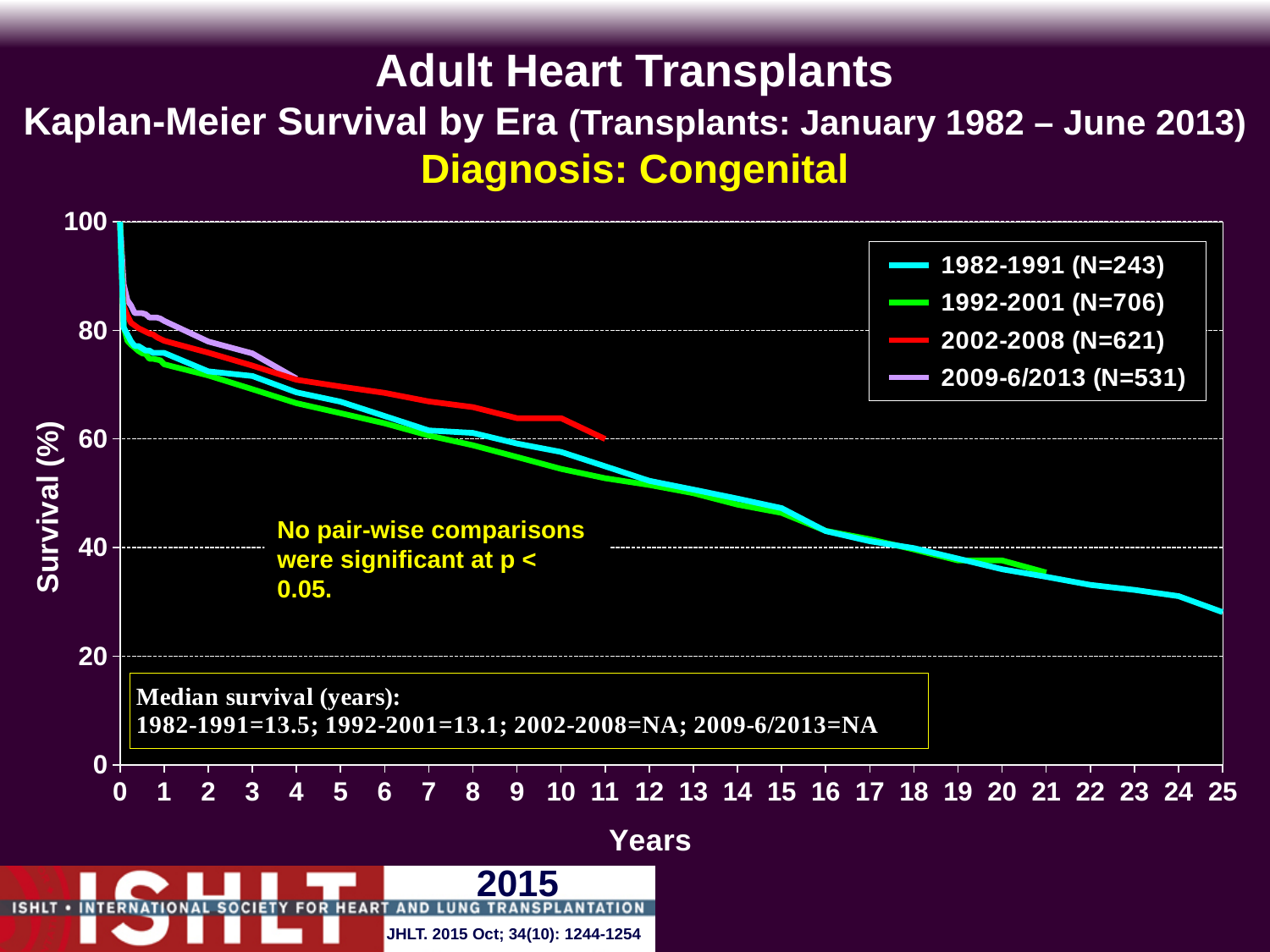
Which era has the largest N in the legend? 1992-2001 Is the survival for the 2002-2008 era at 5 years greater or less than 60? greater What is the median survival for the 2002-2008 era? NA How many series does the legend list? 4 Which era has the smallest N in the legend? 1982-1991 What is the difference in N between the 1992-2001 era and the 2002-2008 era? 85 Do the survival curves rise or fall as years increase? fall What is the N for the 1992-2001 era in the legend? 706 What colour is the line for the 2002-2008 era? red What kind of chart is shown on the slide? line chart Is the survival for the 1982-1991 era at 25 years greater or less than 40? less What is the median survival in years for the 1982-1991 era? 13.5